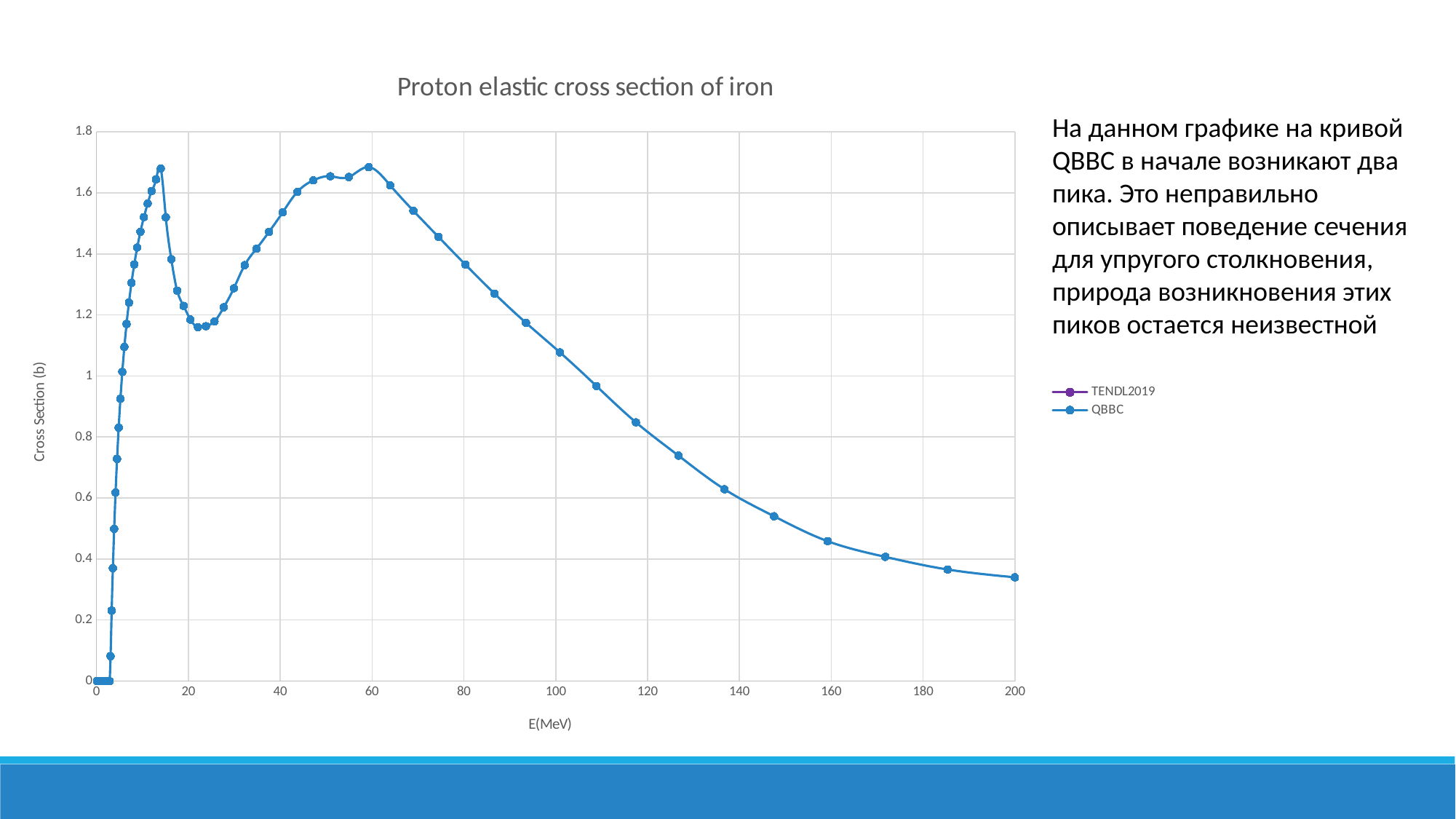
Is the QBBC value at 80 MeV greater or less than 1.2? greater Which is larger for the QBBC curve: the value at 60 MeV or the value at 120 MeV? 60 MeV Is the QBBC value at 200 MeV greater or less than 0.4? less What is the title of the chart? Proton elastic cross section of iron Is the QBBC value at 60 MeV greater or less than 1.6? greater How many series does the legend list? 2 What is the label of the x axis? E(MeV) What kind of chart is shown on the slide? line chart Does the QBBC curve rise or fall between 100 MeV and 200 MeV? fall